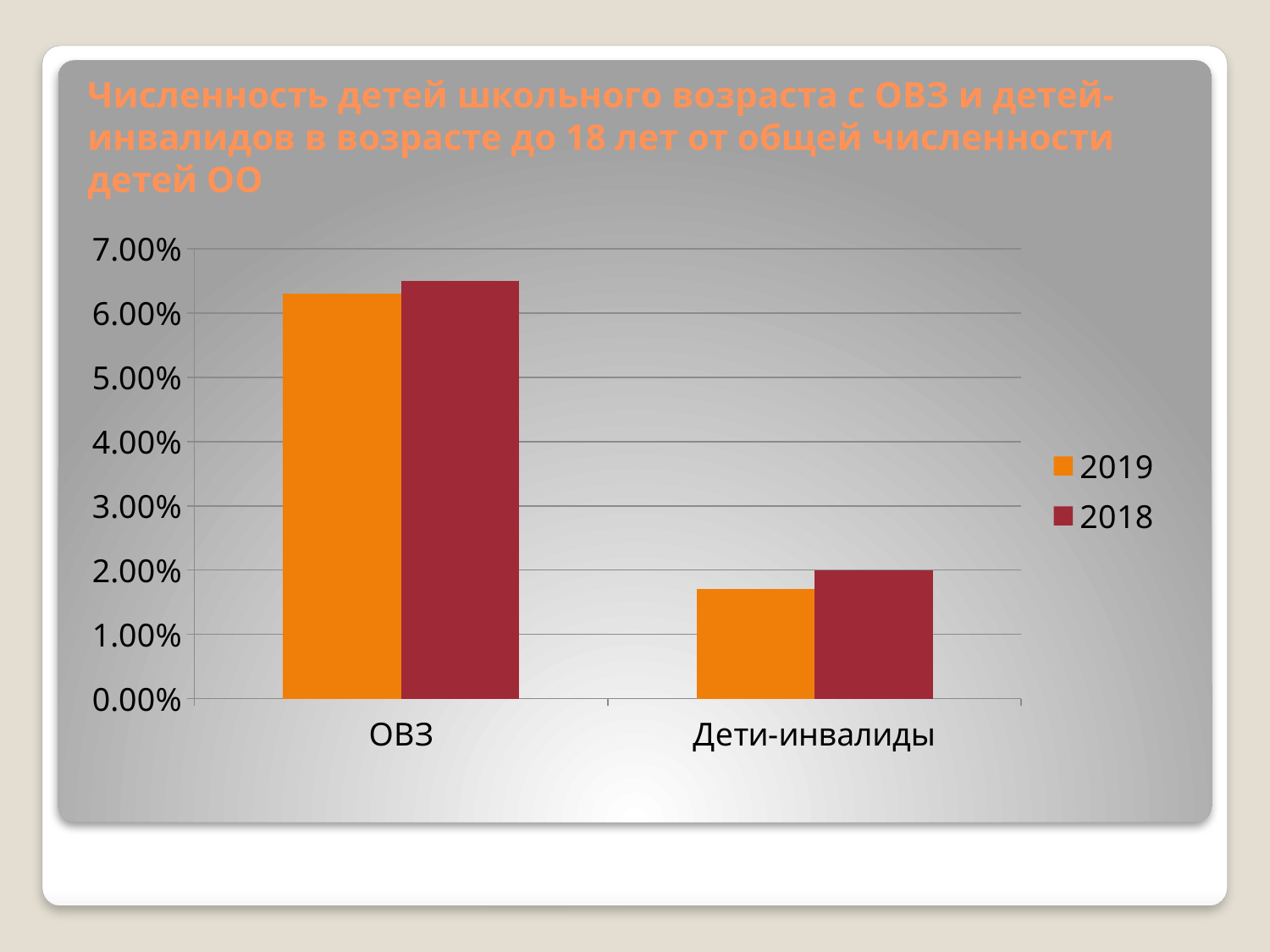
Is the 2018 value for ОВЗ greater or less than 7.00%? less Which category has the lowest values? Дети-инвалиды How many categories are shown on the x axis? 2 Is the 2019 value for ОВЗ greater or less than 6.00%? greater For ОВЗ, which year has the larger value, 2019 or 2018? 2018 For Дети-инвалиды, which year has the larger value, 2019 or 2018? 2018 Which series is shown in orange in the legend? 2019 What kind of chart is shown on the slide? bar chart Which category has the highest values, ОВЗ or Дети-инвалиды? ОВЗ How many series does the legend list? 2 Is the 2019 value for Дети-инвалиды greater or less than 2.00%? less